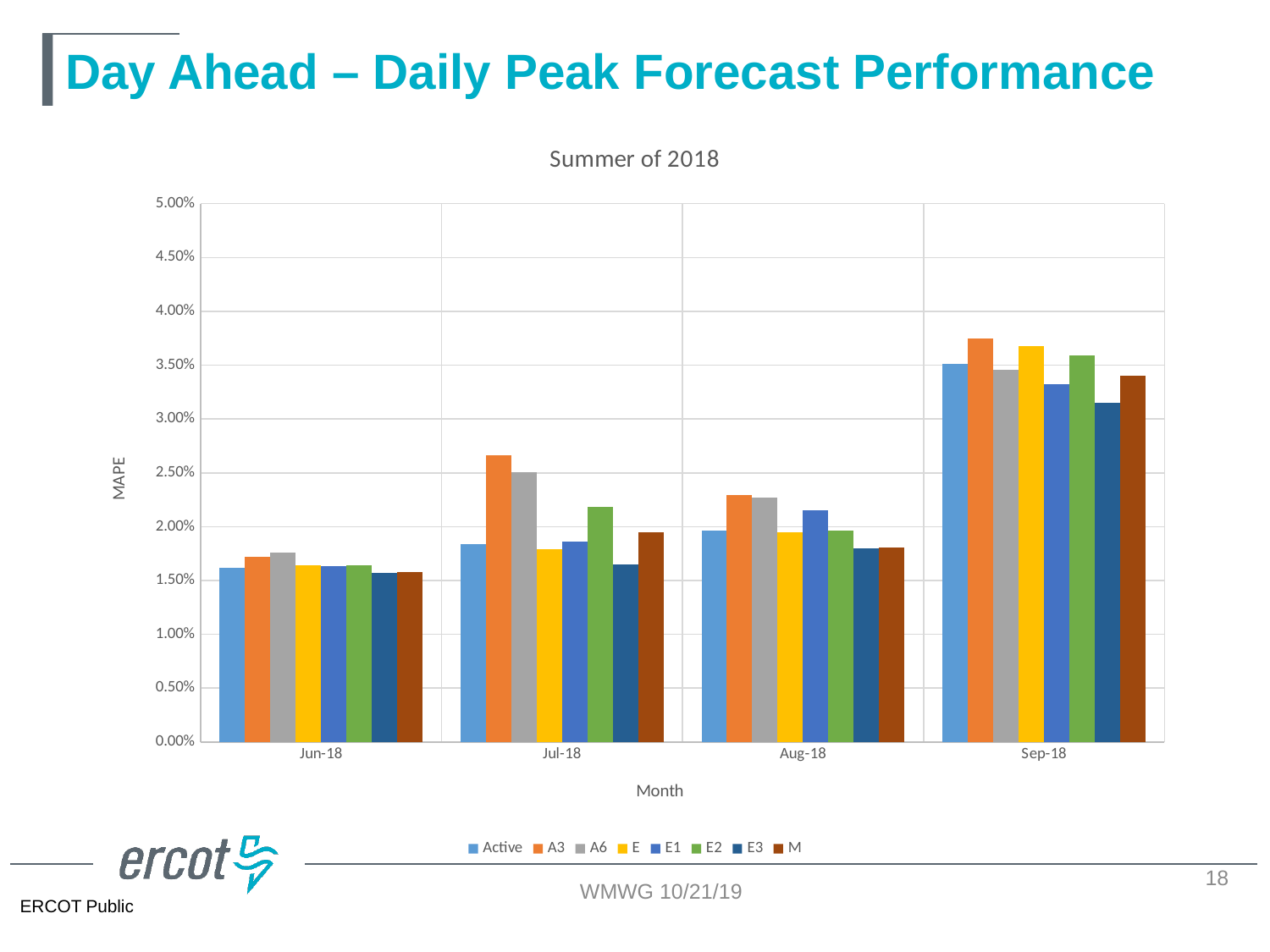
Which series has the lowest MAPE in Jul-18? E3 How many months are shown on the x axis? 4 What type of chart is shown on the slide? bar chart Which is larger, the MAPE for A3 in Jul-18 or the MAPE for A3 in Aug-18? Jul-18 Is the MAPE for E3 in Aug-18 greater or less than 2.00%? less Which series has the highest MAPE in Sep-18? A3 What is the label of the y axis? MAPE Which month has the highest MAPE values overall? Sep-18 How many series does the legend list? 8 Is the MAPE for A3 in Sep-18 greater or less than 3.50%? greater What is the title of the chart? Summer of 2018 Does the MAPE for the Active series rise or fall from Jun-18 to Sep-18? rise